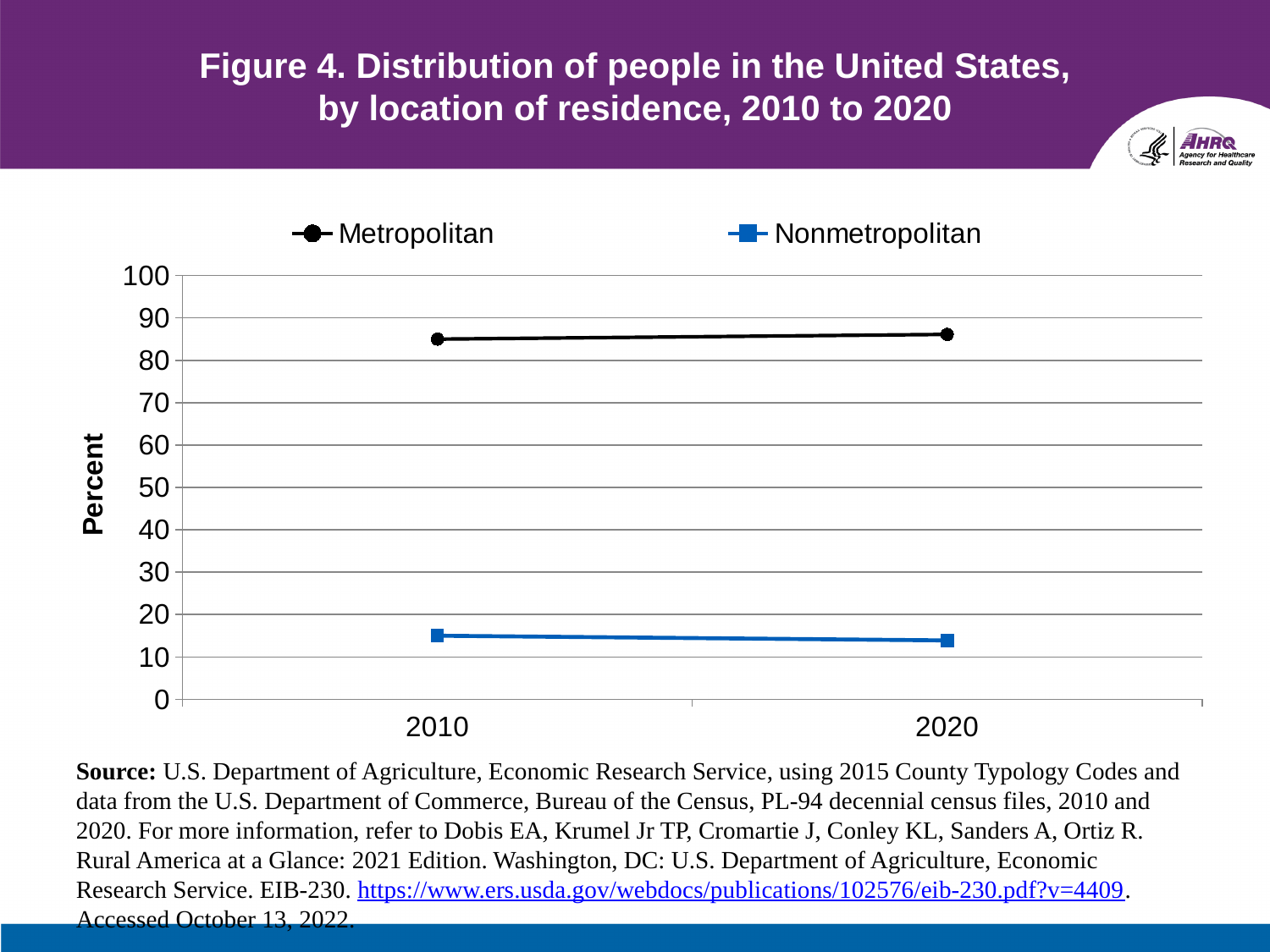
Which series is drawn with square markers? Nonmetropolitan How many years are shown on the x axis? 2 Which series has the larger value in 2020, Metropolitan or Nonmetropolitan? Metropolitan What is the label on the y axis? Percent What kind of chart is shown on the slide? Line chart How many series does the legend list? 2 Is the value for Nonmetropolitan in 2020 greater or less than 10? greater Does the Metropolitan line rise or fall from 2010 to 2020? Rise Is the value for Nonmetropolitan in 2010 greater or less than 20? less Is the value for Metropolitan in 2020 greater or less than 90? less Does the Nonmetropolitan line rise or fall from 2010 to 2020? Fall